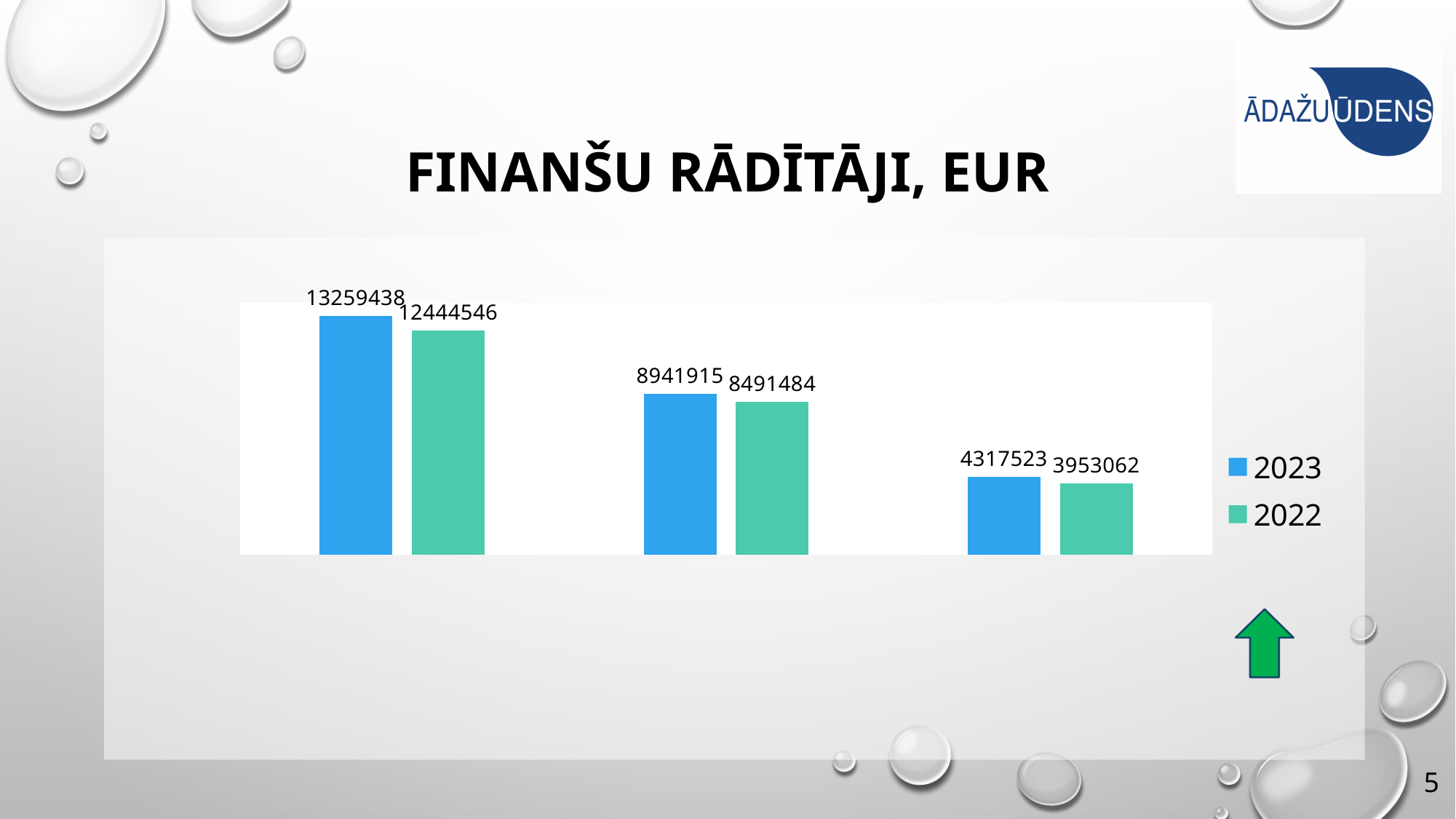
How many groups of bars are plotted in the chart? 3 What is the 2023 value for the third (rightmost) group of bars? 4317523 What is the 2023 value for the first (leftmost) group of bars? 13259438 What is the title of the slide containing the chart? FINANŠU RĀDĪTĀJI, EUR In the third (rightmost) group, which is larger: the 2023 value or the 2022 value? 2023 Which years are listed in the chart legend? 2023 and 2022 Which bar in the chart has the highest value? 2023 bar in the first group (13259438) What is the difference between the 2023 and 2022 values in the first (leftmost) group? 814892 How many series does the chart legend list? 2 What type of chart is shown on the slide? bar chart Which bar in the chart has the lowest value? 2022 bar in the third group (3953062) What is the 2022 value for the second (middle) group of bars? 8491484